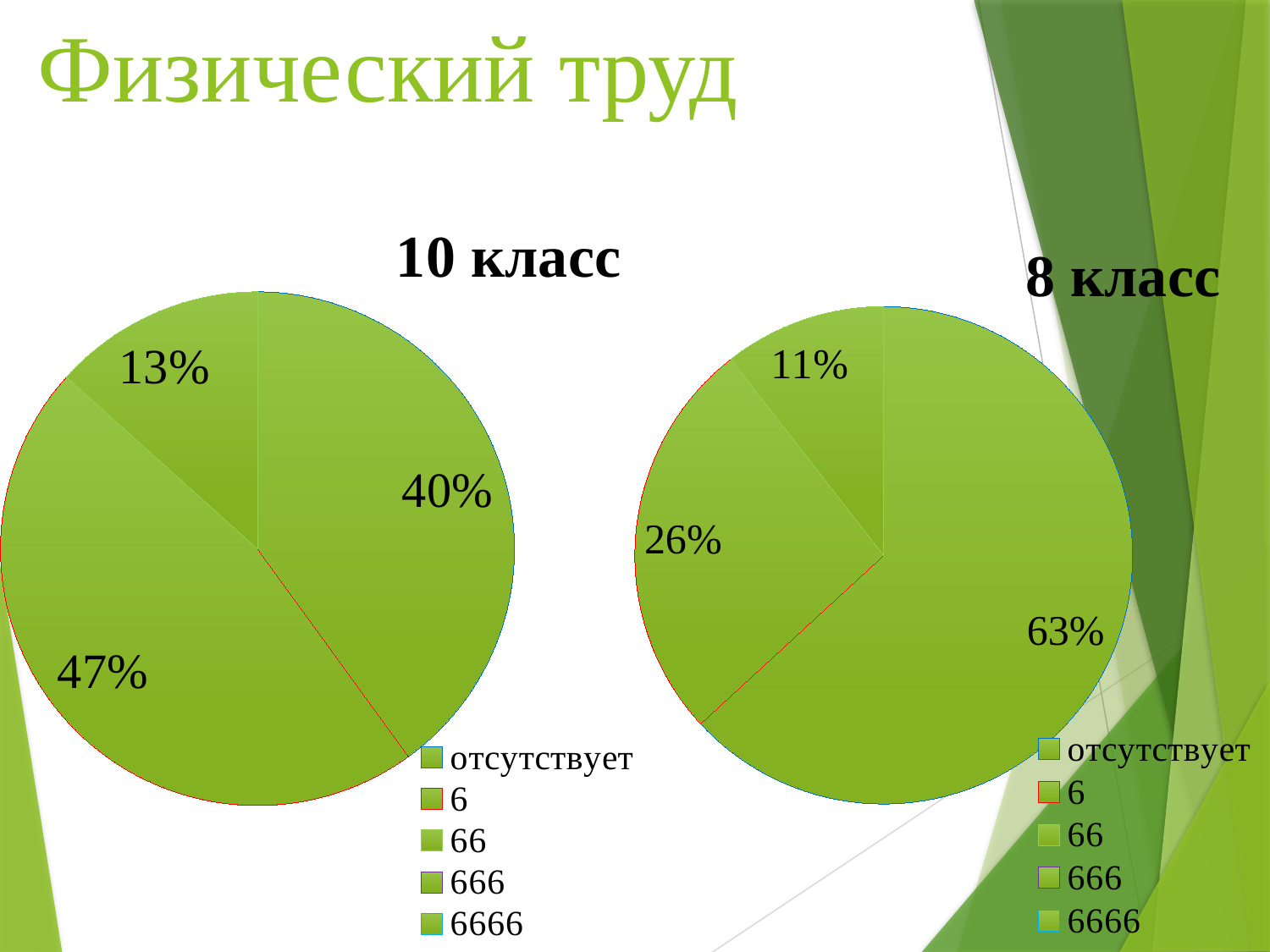
What kind of chart is shown under the heading "8 класс"? pie chart How many entries does the legend of the "8 класс" pie chart list? 5 In the "10 класс" pie chart, what is the largest slice's percentage? 47% How many labelled slices does the "10 класс" pie chart have? 3 In the "8 класс" pie chart, what is the difference between the 63% slice and the 26% slice? 37% In the "10 класс" pie chart, what is the difference between the 47% slice and the 40% slice? 7% In the "8 класс" pie chart, what is the smallest slice's percentage? 11% What kind of chart is shown under the heading "10 класс"? pie chart In the "8 класс" pie chart, what is the largest slice's percentage? 63% What is the title of the slide containing the two pie charts? Физический труд In the "10 класс" pie chart, what is the smallest slice's percentage? 13% How many labelled slices does the "8 класс" pie chart have? 3